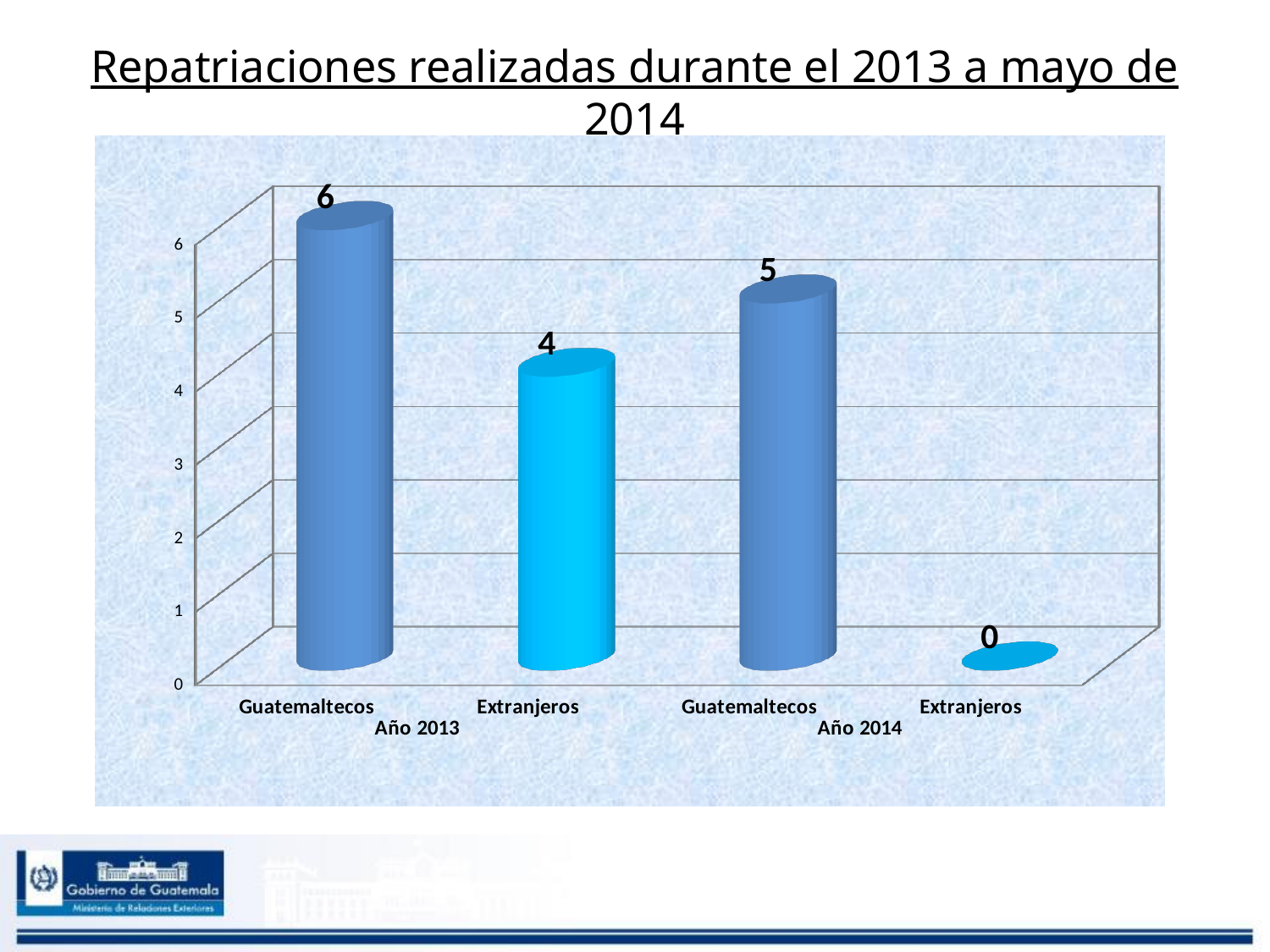
Which bar has the lowest value? Extranjeros, Año 2014 What is the value for Extranjeros in Año 2014? 0 What is the value for Extranjeros in Año 2013? 4 What is the value for Guatemaltecos in Año 2014? 5 What is the value for Guatemaltecos in Año 2013? 6 What kind of chart is shown on the slide? Bar chart What is the title of the slide? Repatriaciones realizadas durante el 2013 a mayo de 2014 What is the difference between Guatemaltecos and Extranjeros in Año 2013? 2 How many bars are plotted in the chart? 4 Which bar has the highest value? Guatemaltecos, Año 2013 What is the difference between Guatemaltecos in Año 2013 and Guatemaltecos in Año 2014? 1 Which is larger: Extranjeros in Año 2013 or Guatemaltecos in Año 2014? Guatemaltecos in Año 2014